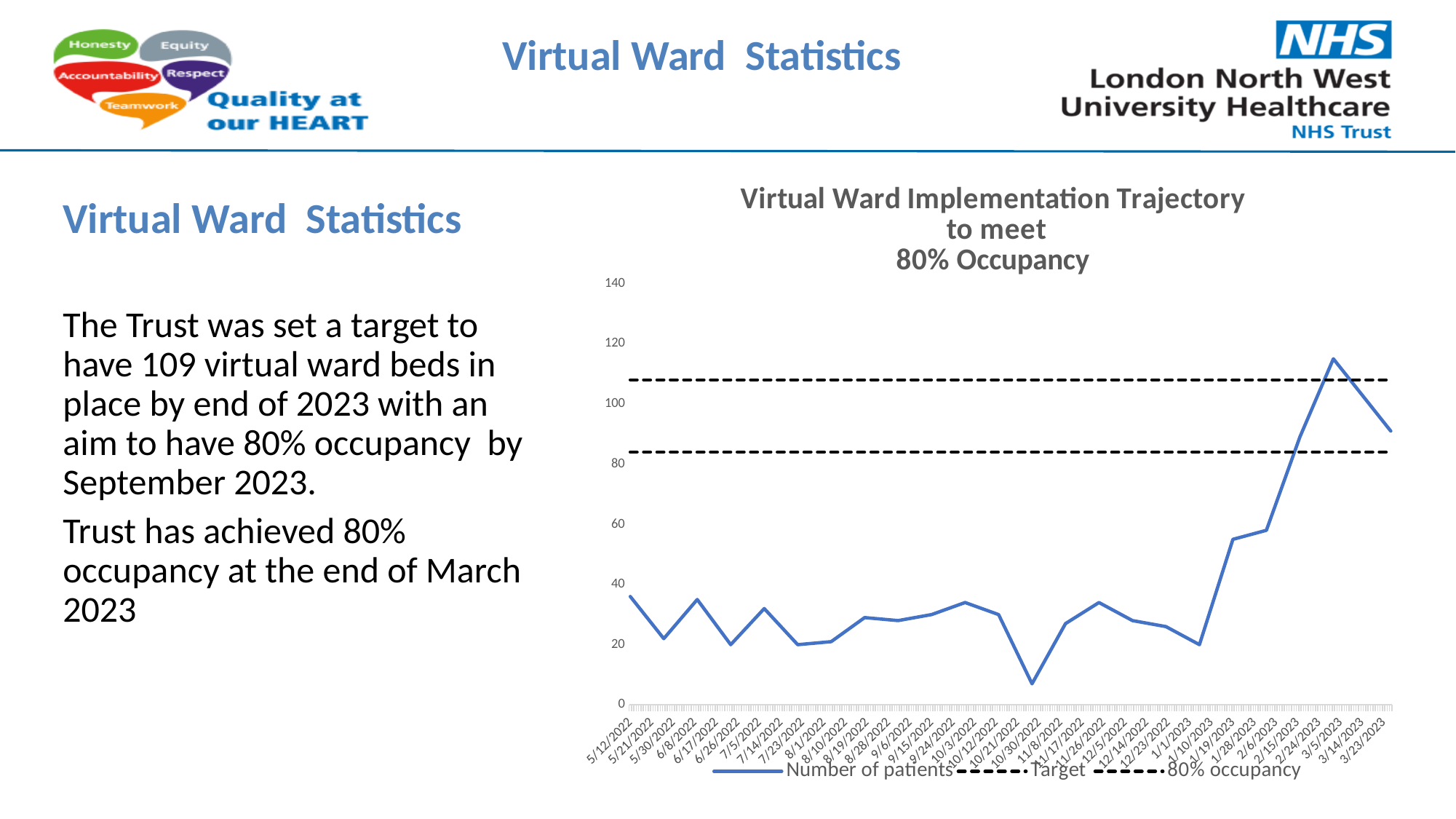
What kind of chart is shown on the slide? line chart Which is larger, the Number of patients on 3/5/2023 or on 3/23/2023? 3/5/2023 Is the Number of patients value on 10/30/2022 greater or less than 20? less What is the title of the chart? Virtual Ward Implementation Trajectory to meet 80% Occupancy What are the three series listed in the chart legend? Number of patients, Target, 80% occupancy Is the Number of patients value on 5/12/2022 greater or less than 40? less Which dashed line sits higher on the chart, Target or 80% occupancy? Target Overall, does the Number of patients line rise or fall from 5/12/2022 to 3/23/2023? rise How many series does the chart legend list? 3 Is the Number of patients value on 3/5/2023 greater or less than 100? greater